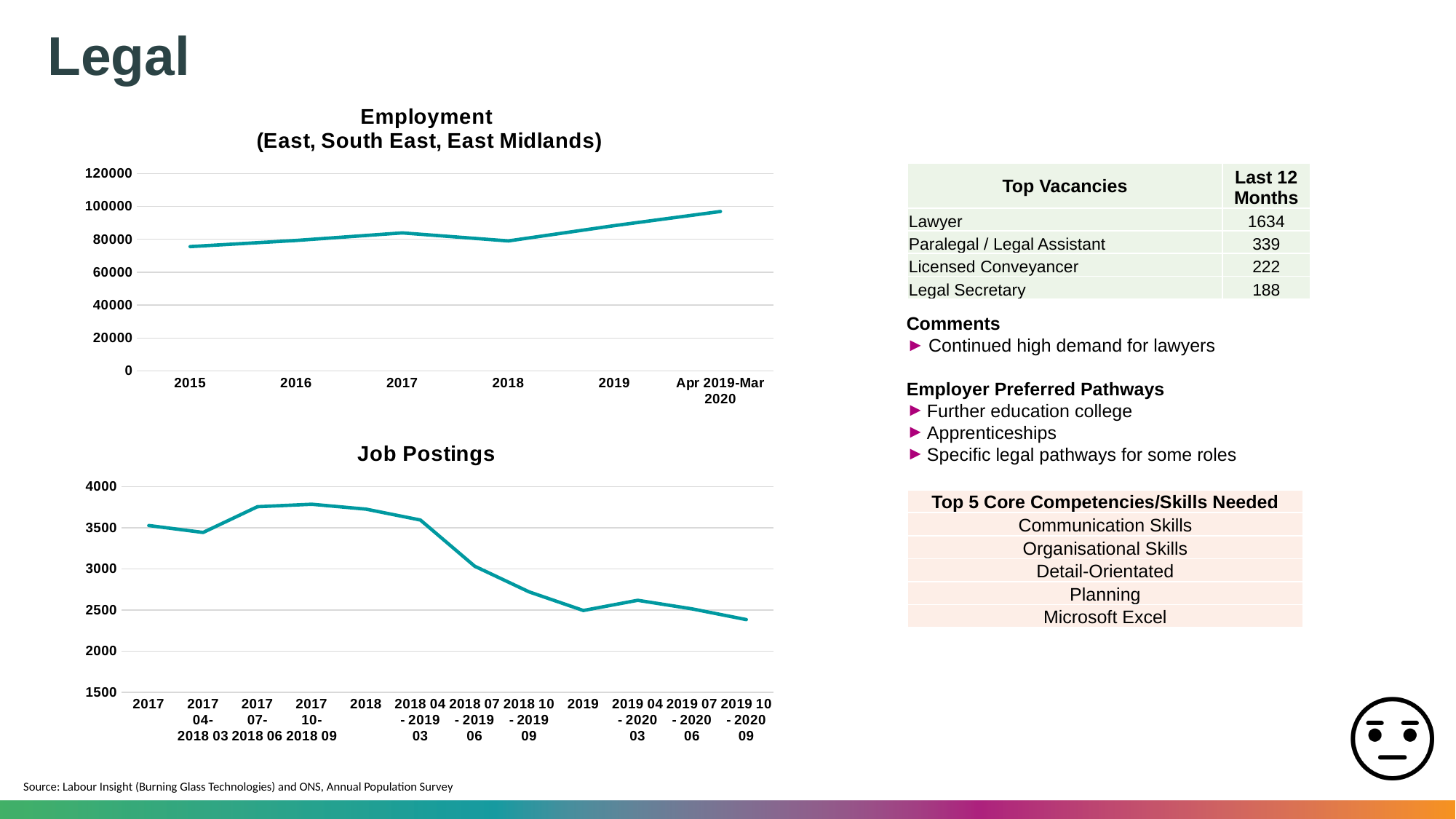
In the Job Postings chart, which period has the lowest number of job postings? 2019 10 - 2020 09 What type of chart is the Employment (East, South East, East Midlands) chart? line chart In the Employment (East, South East, East Midlands) chart, is the value for 2015 greater or less than 80000? less In the Employment (East, South East, East Midlands) chart, is the value for Apr 2019-Mar 2020 greater or less than 100000? less In the Employment (East, South East, East Midlands) chart, which year has the lowest employment? 2015 In the Employment (East, South East, East Midlands) chart, which period has the highest employment? Apr 2019-Mar 2020 In the Job Postings chart, which is larger, the value for 2017 or the value for 2019? 2017 In the Job Postings chart, how many periods are plotted on the x axis? 12 In the Employment (East, South East, East Midlands) chart, which is larger, the value for 2017 or the value for 2018? 2017 In the Job Postings chart, is the value for 2018 10 - 2019 09 greater or less than 3000? less In the Employment (East, South East, East Midlands) chart, how many periods are plotted on the x axis? 6 In the Job Postings chart, do job postings overall rise or fall from 2017 to 2019 10 - 2020 09? fall